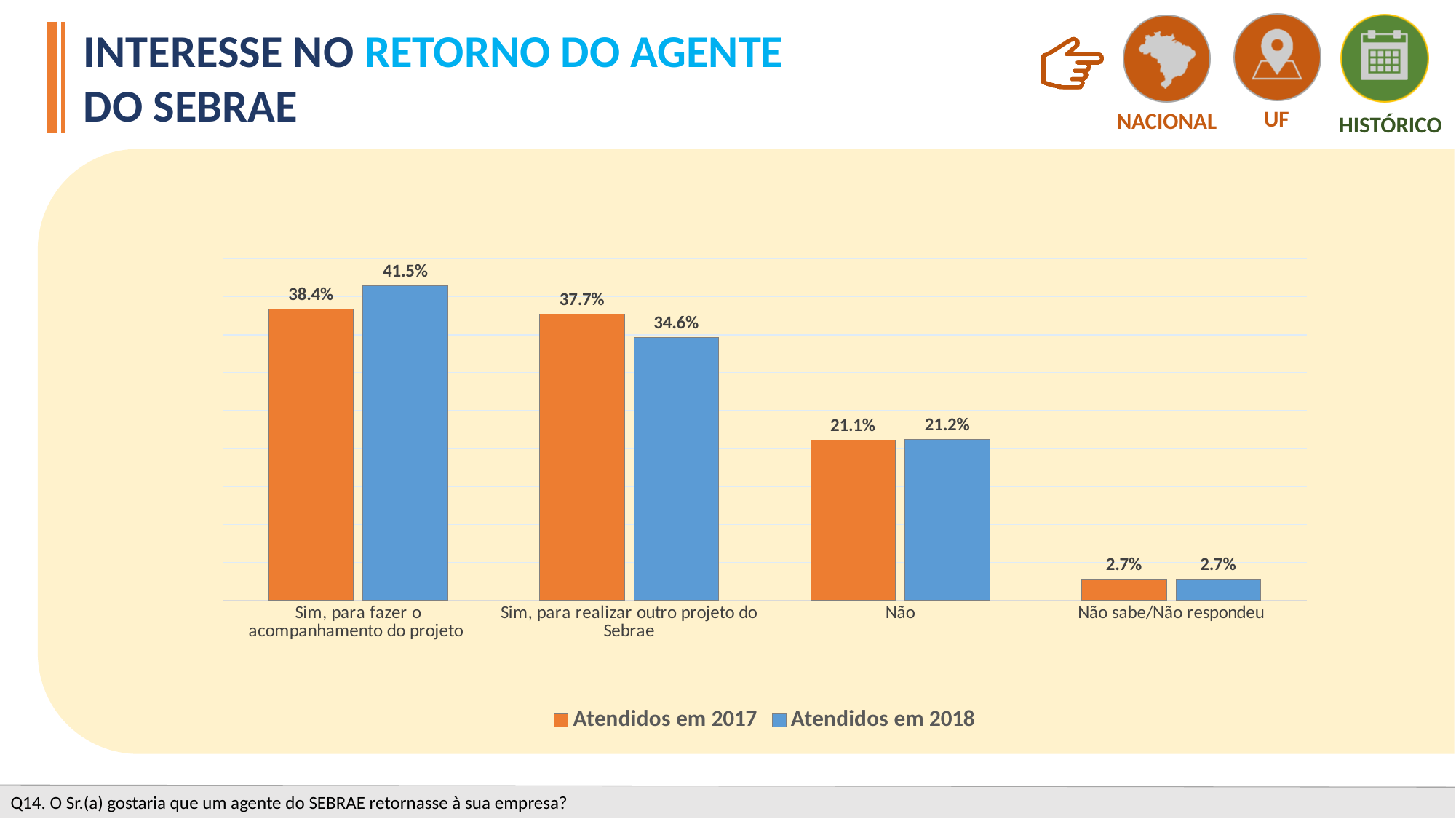
What is the value for 'Atendidos em 2018' in the category 'Sim, para fazer o acompanhamento do projeto'? 41.5% How many categories are shown on the x axis? 4 Which series is shown in blue in the legend? Atendidos em 2018 How many series does the legend list? 2 What is the value for 'Atendidos em 2018' in the category 'Sim, para realizar outro projeto do Sebrae'? 34.6% What is the value for 'Atendidos em 2017' in the category 'Não'? 21.1% Which category has the lowest value for 'Atendidos em 2018'? Não sabe/Não respondeu What is the difference between the 2018 and 2017 values for 'Sim, para fazer o acompanhamento do projeto'? 3.1% What kind of chart is shown on the slide? Bar chart What is the difference between the 2017 and 2018 values for 'Sim, para realizar outro projeto do Sebrae'? 3.1% Which category has the highest value for 'Atendidos em 2017'? Sim, para fazer o acompanhamento do projeto For 'Sim, para realizar outro projeto do Sebrae', which series has the larger value, 'Atendidos em 2017' or 'Atendidos em 2018'? Atendidos em 2017